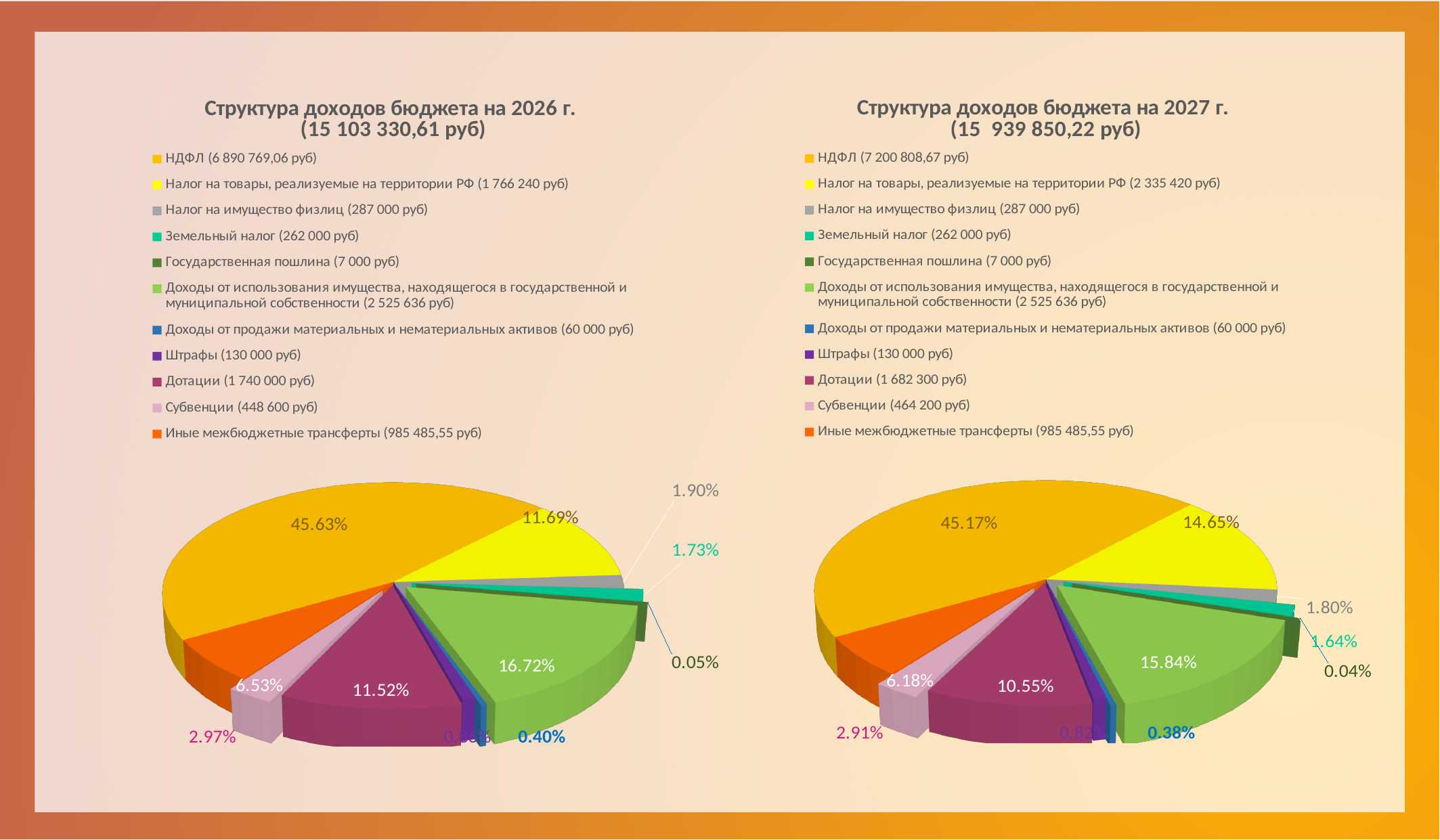
In the 2026 chart, what is the share of Дотации? 11.52% Is the share of Дотации larger in the 2026 chart or the 2027 chart? 2026 How many categories does the legend of the 2027 chart list? 11 In the 2026 chart, what is the difference between the share of Доходы от использования имущества (16.72%) and the share of Дотации (11.52%)? 5.20% What total amount is shown in the title of the 2026 chart? 15 103 330,61 руб What kind of chart is used on the left for the 2026 budget income structure? Pie chart In the 2026 chart, which category has the largest slice? НДФЛ In the 2027 chart, what is the share of Доходы от использования имущества, находящегося в государственной и муниципальной собственности? 15.84% In the 2026 chart (Структура доходов бюджета на 2026 г.), what share does НДФЛ have? 45.63% According to the legend of the 2027 chart, what is the amount for Дотации? 1 682 300 руб In the 2027 chart, which category has the smallest slice? Государственная пошлина